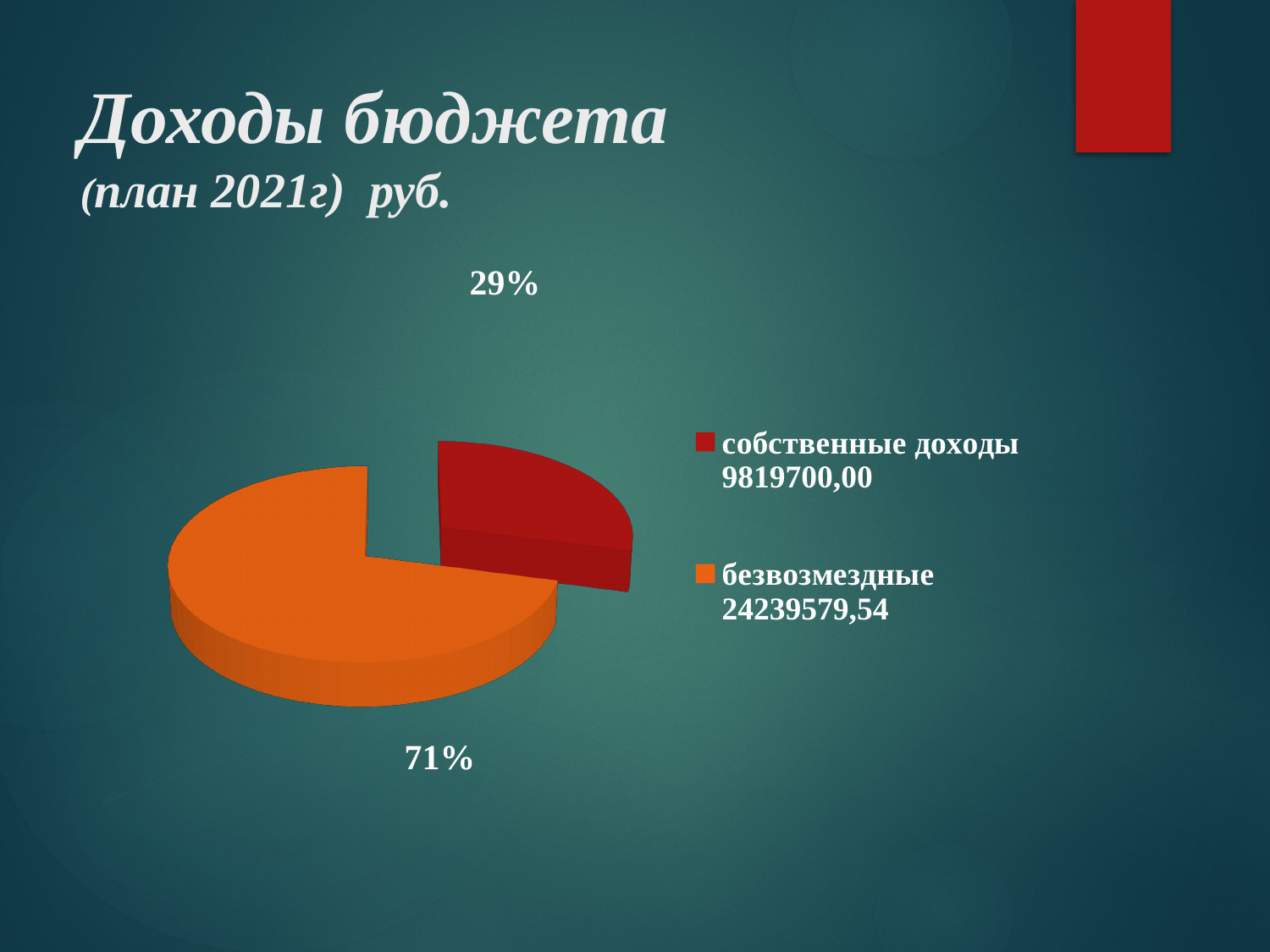
Which category has the smallest share of the pie? собственные доходы What share of the pie does the slice for собственные доходы represent? 29% By how many percentage points does the share for безвозмездные exceed the share for собственные доходы? 42 Which category has the largest share of the pie? безвозмездные How many slices does the pie chart have? 2 Which is larger, the share for безвозмездные or the share for собственные доходы? безвозмездные What share of the pie does the slice for безвозмездные represent? 71% What value is given in the legend for безвозмездные? 24239579,54 What value is given in the legend for собственные доходы? 9819700,00 What colour is the slice for собственные доходы? red What is the title of the chart on the slide? Доходы бюджета (план 2021г) руб. What kind of chart is shown on the slide? pie chart